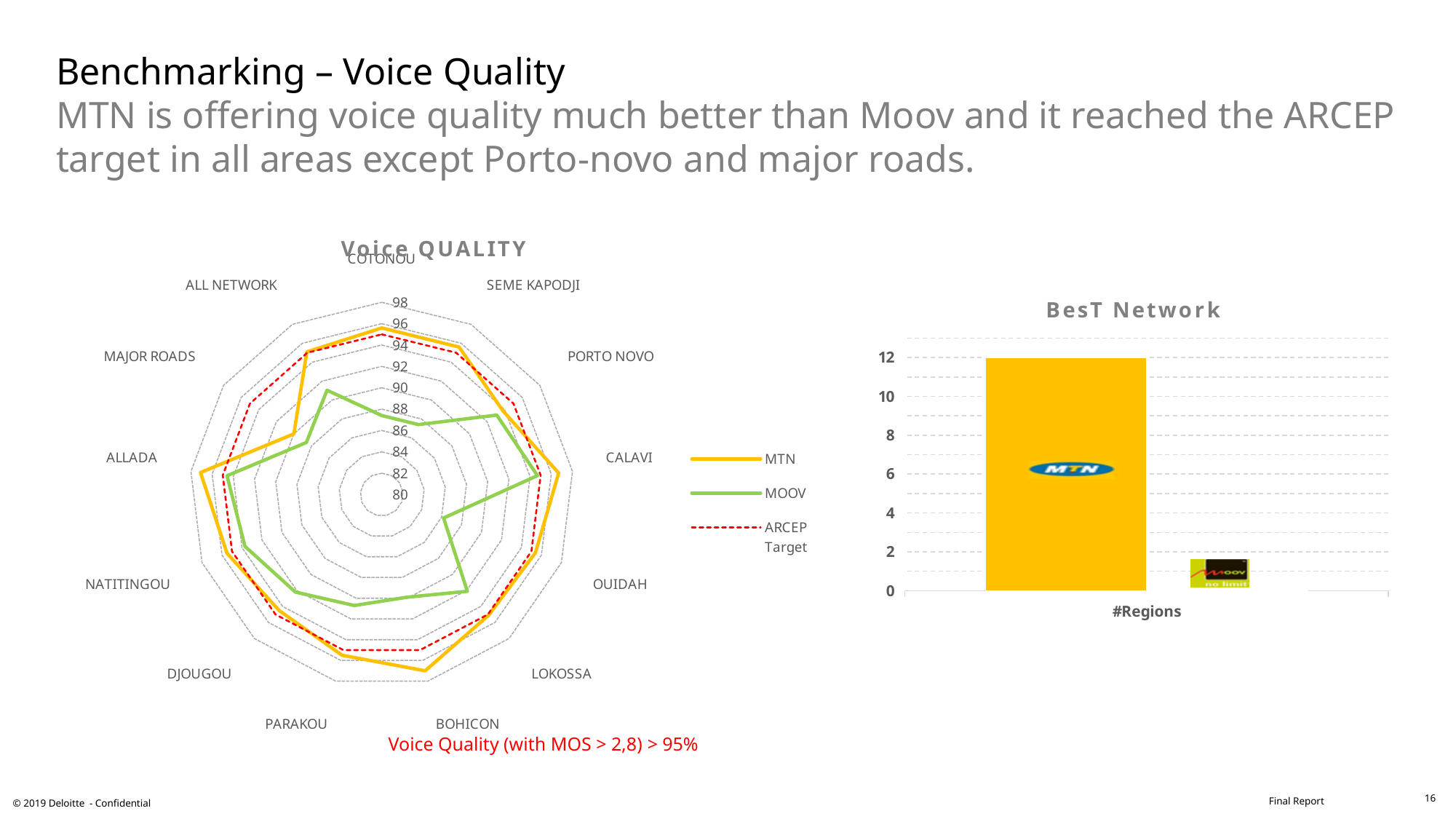
In the BesT Network chart, is the value for Moov greater or less than 4? less In the Voice QUALITY chart, is the MOOV value for OUIDAH greater or less than 90? less In the Voice QUALITY chart, is the MTN value for ALLADA greater or less than 94? greater What kind of chart is the Voice QUALITY chart on the left of the slide? radar chart In the BesT Network chart, which operator has the taller bar, MTN or Moov? MTN In the Voice QUALITY chart, how many series does the legend list? 3 In the Voice QUALITY chart, how many categories are plotted around the radar? 13 What kind of chart is the BesT Network chart on the right of the slide? bar chart In the Voice QUALITY chart, which legend entry is drawn as a red dashed line? ARCEP Target In the BesT Network chart, what is the value of the MTN bar? 12 In the Voice QUALITY chart, which series has the higher value at OUIDAH, MTN or MOOV? MTN